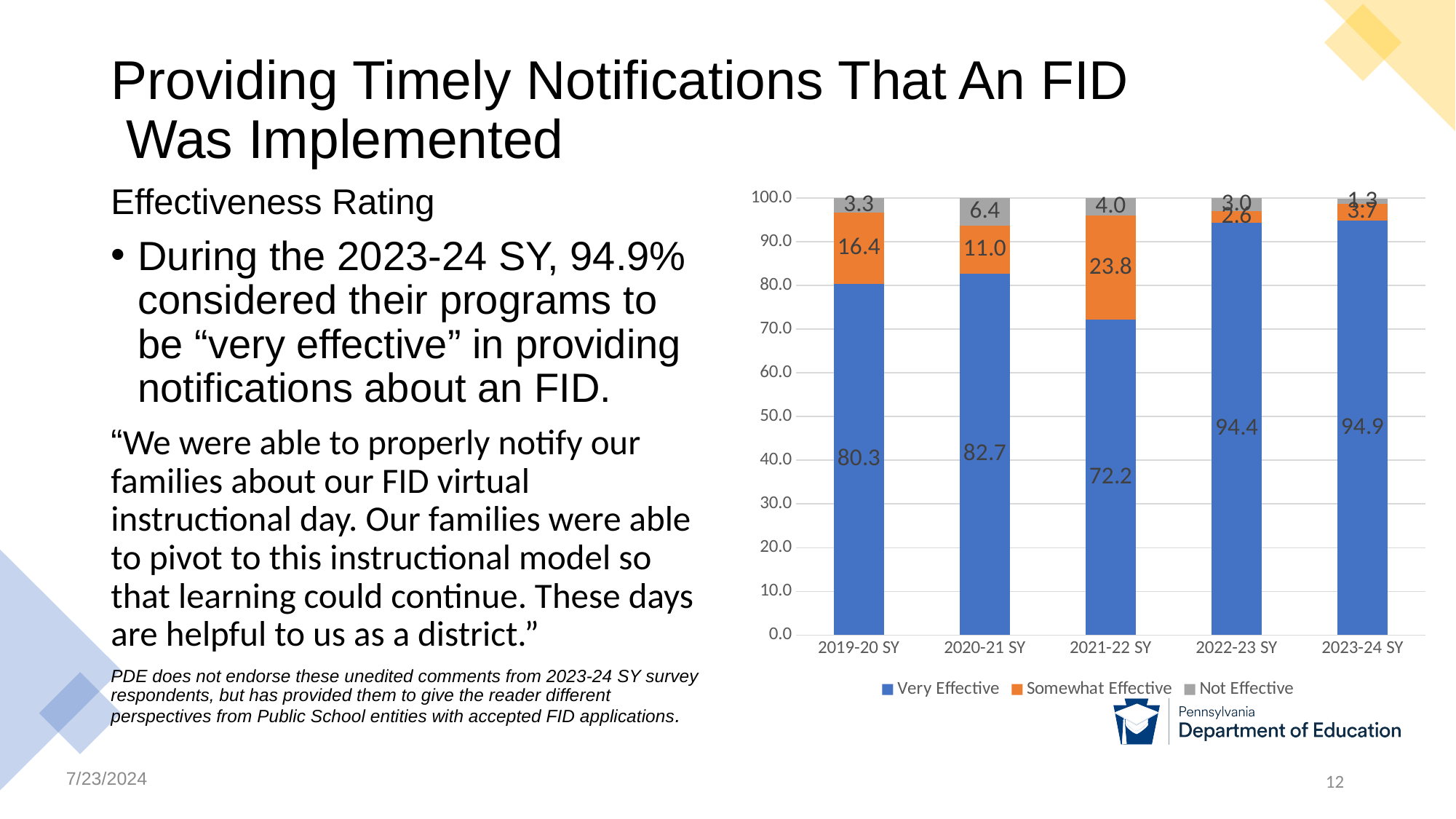
What is the Somewhat Effective value for the 2021-22 SY? 23.8 What is the Very Effective value for the 2019-20 SY? 80.3 Which series is shown in orange in the chart? Somewhat Effective How many series does the chart legend list? 3 Which school year has the highest Somewhat Effective value? 2021-22 SY How many school years are shown on the x axis of the chart? 5 What is the Not Effective value for the 2020-21 SY? 6.4 What is the Very Effective value for the 2023-24 SY? 94.9 What is the difference between the Very Effective values for the 2023-24 SY and the 2019-20 SY? 14.6 What kind of chart is shown on the slide? Stacked bar chart Is the Very Effective value for the 2020-21 SY greater or less than the Very Effective value for the 2021-22 SY? greater Which school year has the lowest Very Effective value? 2021-22 SY